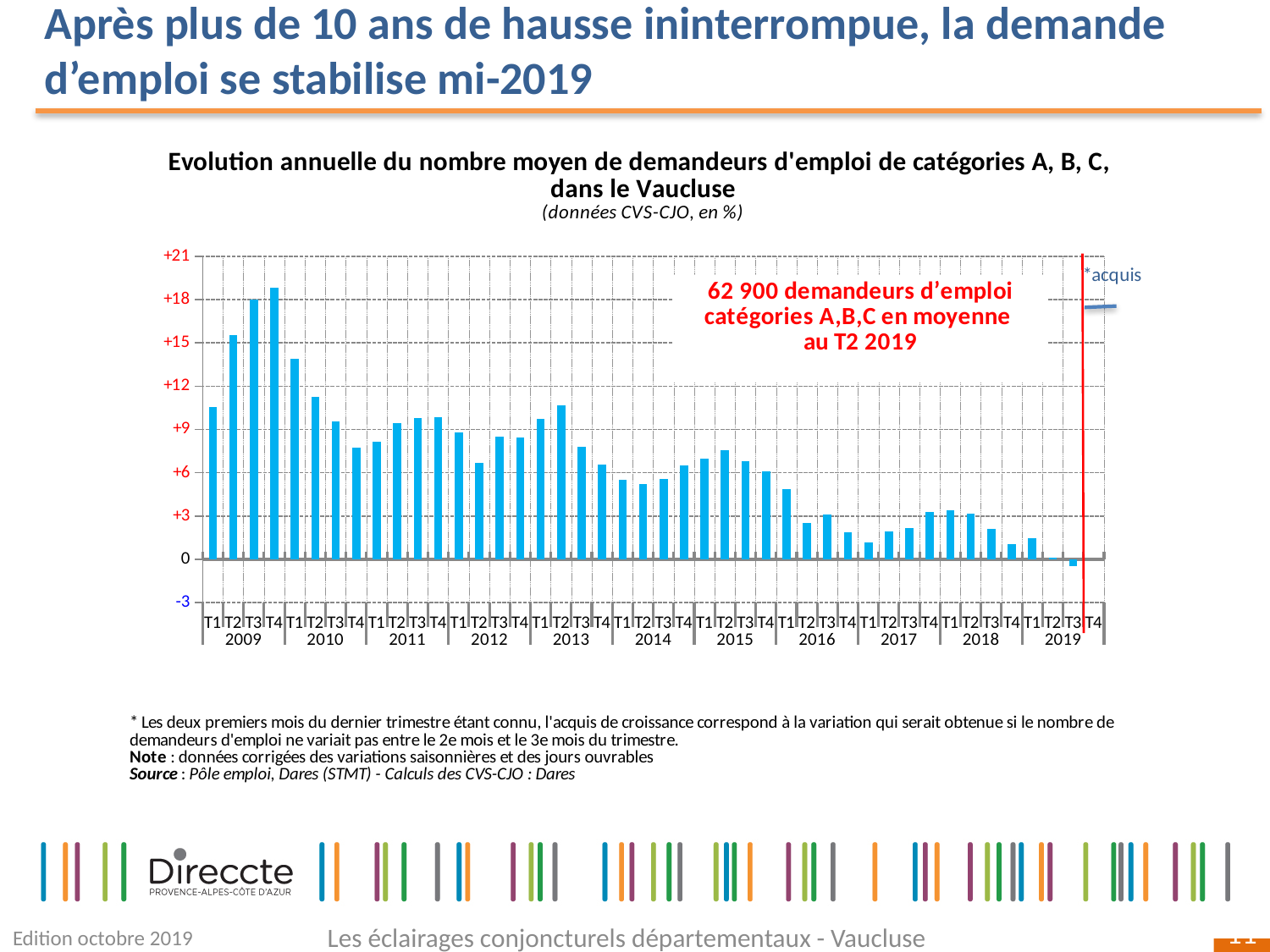
Which is larger, the value for T2 2015 or the value for T2 2016? T2 2015 What kind of chart is shown on the slide? Bar chart Is the value for T1 2016 greater or less than +6? less Which quarter has the lowest value in the chart? T3 2019 Is the value for T1 2009 greater or less than +9? greater Is the value for T3 2019 greater or less than 0? less Do the values generally rise or fall from 2009 to 2019? Fall Which quarter has the highest value in the chart? T4 2009 According to the annotation on the chart, how many job seekers in categories A, B, C were there on average in T2 2019? 62 900 How many years are labelled along the x axis? 11